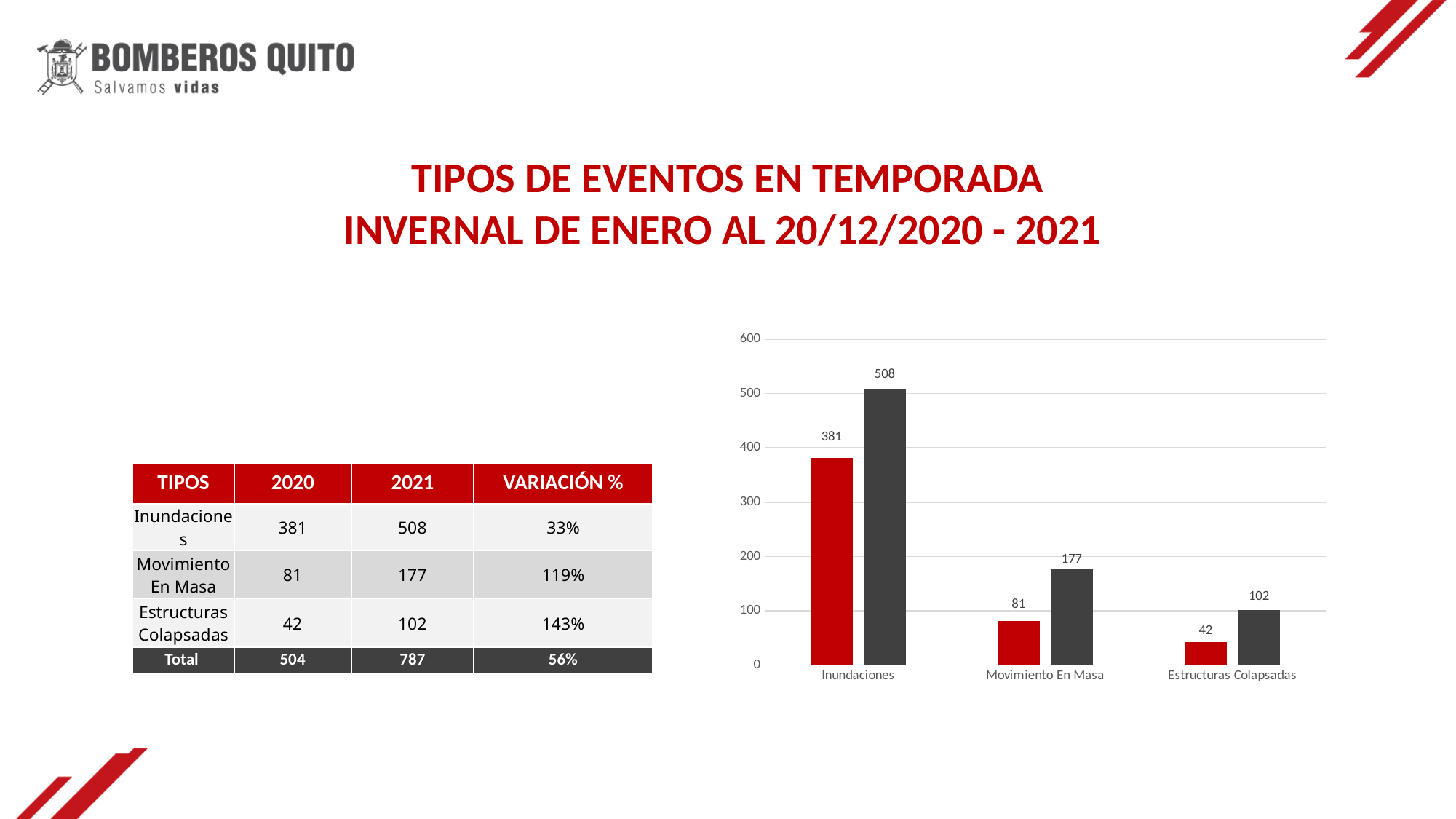
What is the value of the red bar for Inundaciones? 381 What is the difference between the dark grey bar and the red bar for Movimiento En Masa? 96 How many categories are shown on the x axis of the chart? 3 Is the value of the dark grey bar for Inundaciones greater or less than 500? greater Which is larger for Estructuras Colapsadas, the red bar or the dark grey bar? the dark grey bar What is the value of the dark grey bar for Movimiento En Masa? 177 What is the value of the dark grey bar for Inundaciones? 508 Which category has the lowest red bar? Estructuras Colapsadas What type of chart is shown on the slide? bar chart Which category has the highest dark grey bar? Inundaciones What is the difference between the red bar for Inundaciones and the red bar for Movimiento En Masa? 300 What is the value of the red bar for Estructuras Colapsadas? 42